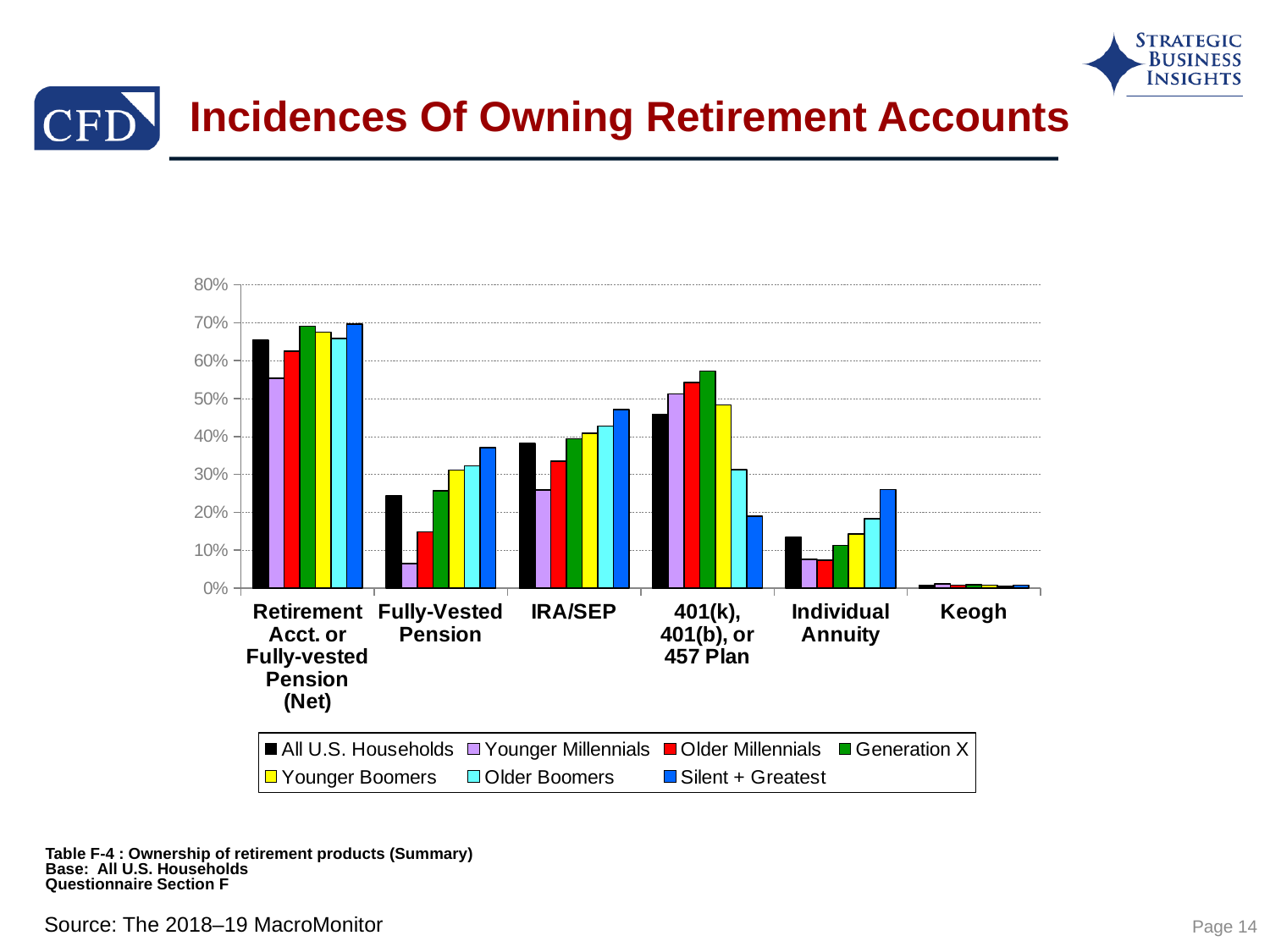
Which series has the highest value in the Individual Annuity category? Silent + Greatest How many retirement product categories are shown along the x axis? 6 How many series does the legend list? 7 What kind of chart is shown on the slide? bar chart Which series has the lowest value in the Fully-Vested Pension category? Younger Millennials Is the value for All U.S. Households in the IRA/SEP category greater or less than 30%? greater Which category has the lowest values across all series? Keogh In the Retirement Acct. or Fully-vested Pension (Net) category, which is larger: Younger Millennials or Silent + Greatest? Silent + Greatest Is the value for Silent + Greatest in the 401(k), 401(b), or 457 Plan category greater or less than 30%? less Which series has the highest value in the 401(k), 401(b), or 457 Plan category? Generation X Is the value for Younger Millennials in the Fully-Vested Pension category greater or less than 10%? less